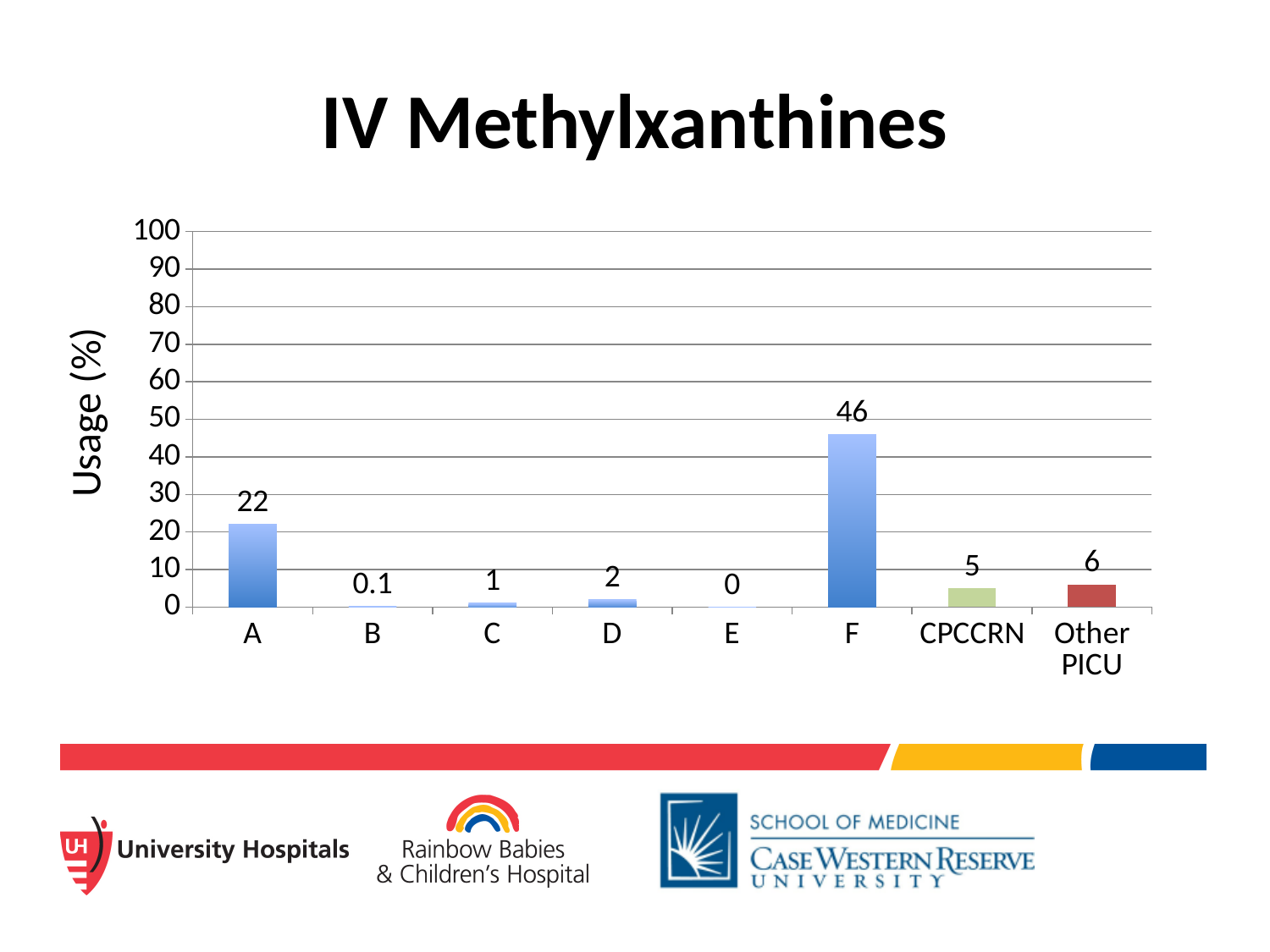
How many categories are shown on the x axis? 8 Which category has the highest usage? F What is the difference in usage between F and A? 24 What is the usage (%) for Other PICU? 6 What is the usage (%) for B? 0.1 What is the title of the chart? IV Methylxanthines What is the usage (%) for F? 46 Which category has the lowest usage? E What is the usage (%) for A? 22 Which has higher usage, Other PICU or CPCCRN? Other PICU What is the usage (%) for CPCCRN? 5 What kind of chart is shown? Bar chart